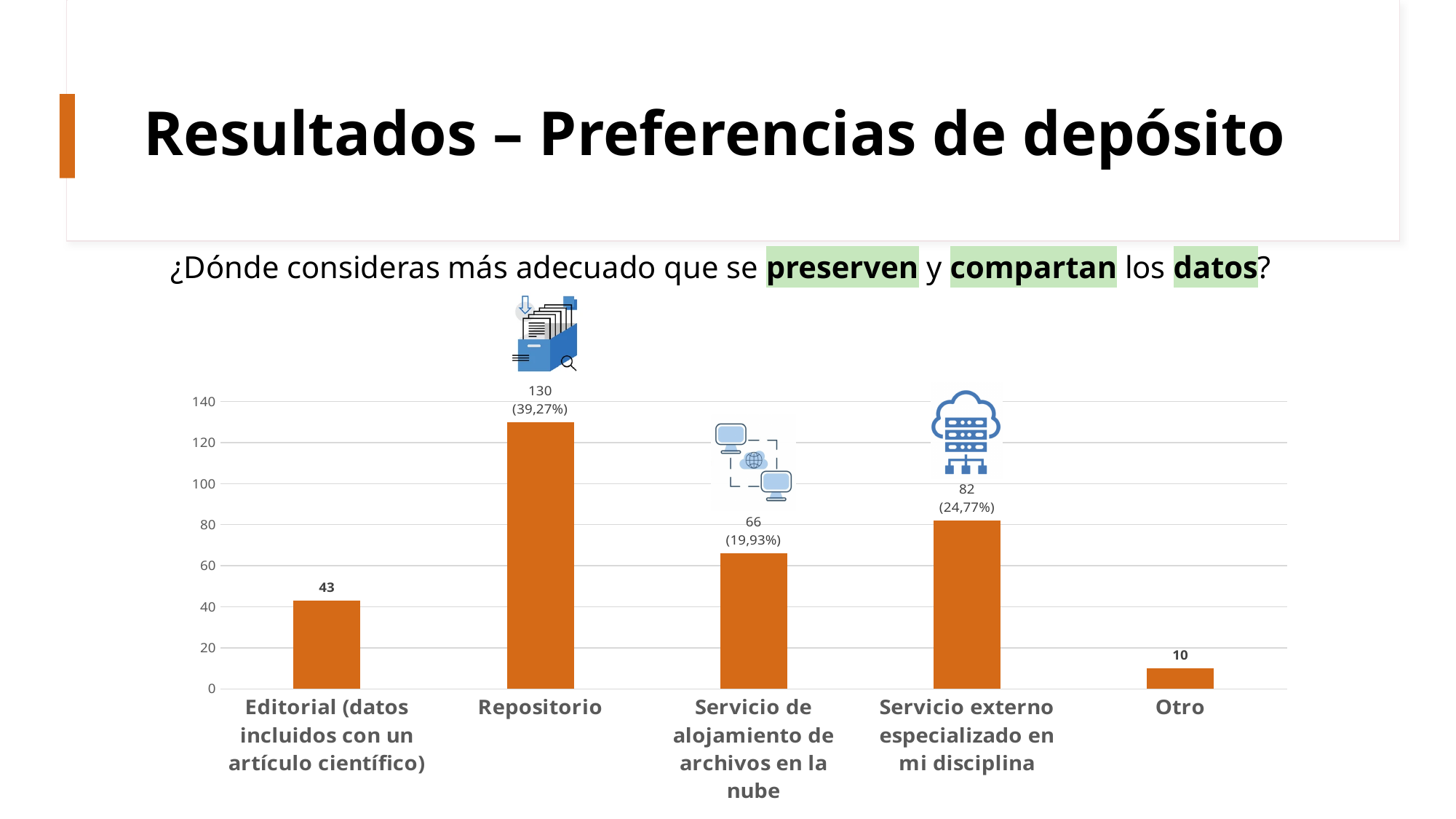
Which category has the lowest value? Otro Which category has the highest value? Repositorio Which is larger, the value for Servicio de alojamiento de archivos en la nube or the value for Editorial (datos incluidos con un artículo científico)? Servicio de alojamiento de archivos en la nube What is the value for Repositorio? 130 What is the value for Editorial (datos incluidos con un artículo científico)? 43 What is the value for Otro? 10 What percentage is shown in parentheses for Repositorio? 39,27% What kind of chart is shown on the slide? bar chart What is the value for Servicio de alojamiento de archivos en la nube? 66 What is the difference between the values for Repositorio and Servicio externo especializado en mi disciplina? 48 How many categories are shown on the x axis? 5 What is the value for Servicio externo especializado en mi disciplina? 82